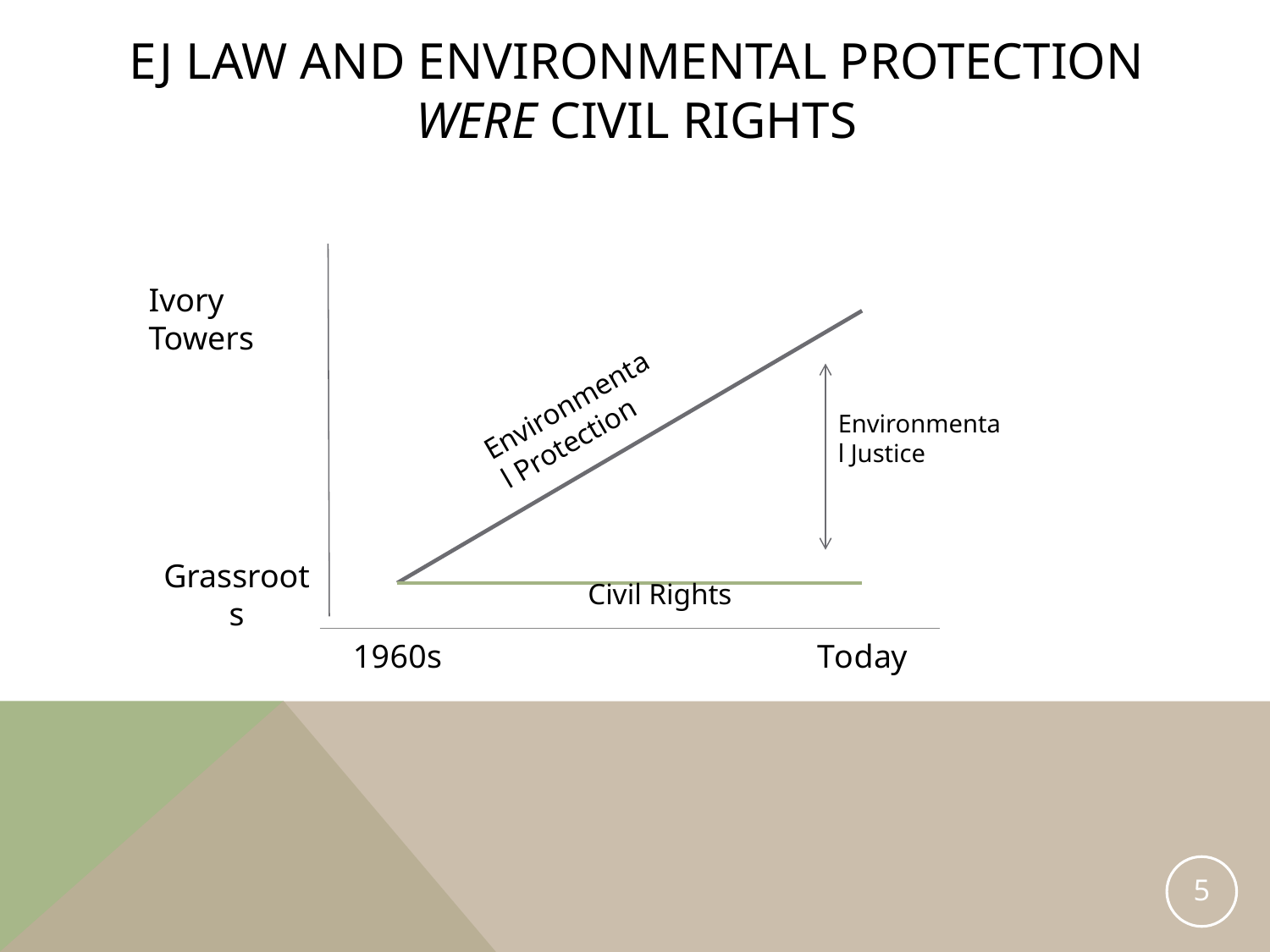
At Today, which line is higher: Environmental Protection or Civil Rights? Environmental Protection How many labels are shown on the x axis of the chart? 2 What are the two labels on the x axis of the chart? 1960s and Today How many lines are plotted on the chart? 2 What kind of chart is shown on the slide? Line chart Does the Civil Rights line rise, fall, or stay flat from the 1960s to Today? Stays flat Does the Environmental Protection line rise or fall from the 1960s to Today? Rises What does the vertical double-headed arrow between the two lines at Today represent? Environmental Justice What label is at the top of the y axis of the chart? Ivory Towers Which line stays at the Grassroots level across the whole chart? Civil Rights